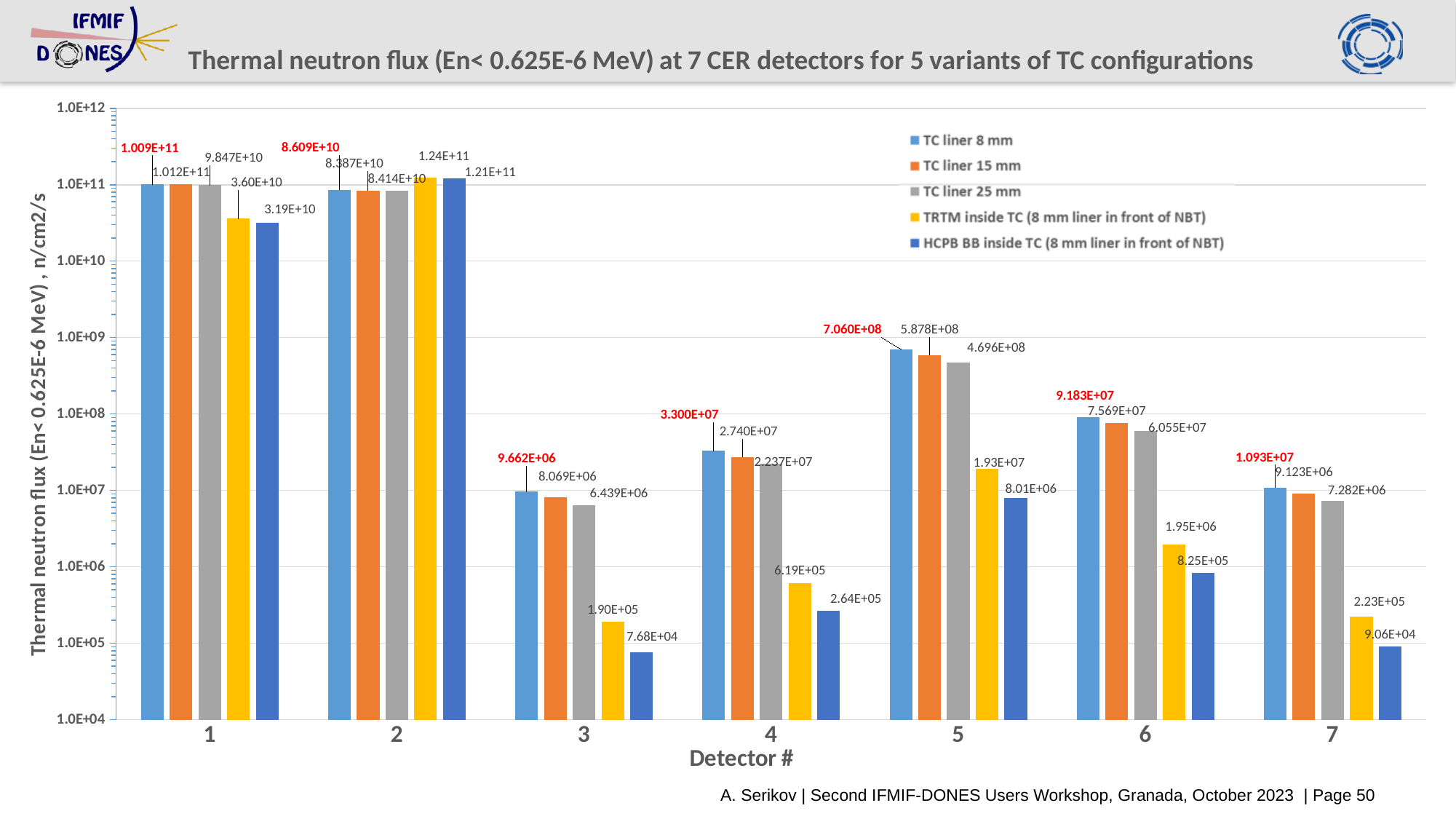
How many detectors are shown on the x axis? 7 Which configuration gives the highest thermal neutron flux at detector 2? TRTM inside TC (8 mm liner in front of NBT) What is the thermal neutron flux at detector 6 for the TC liner 15 mm configuration? 7.569E+07 What kind of chart is shown on the slide? Bar chart How many series does the legend list? 5 What is the thermal neutron flux at detector 2 for the TRTM inside TC configuration? 1.24E+11 Which detector has the lowest thermal neutron flux for the TC liner 8 mm configuration? 3 At detector 4, which is larger: the flux for TC liner 8 mm or for HCPB BB inside TC? TC liner 8 mm What is the thermal neutron flux at detector 5 for the TC liner 25 mm configuration? 4.696E+08 What is the thermal neutron flux at detector 3 for the HCPB BB inside TC configuration? 7.68E+04 What is the thermal neutron flux at detector 1 for the TC liner 8 mm configuration? 1.009E+11 What is the label of the x axis? Detector #